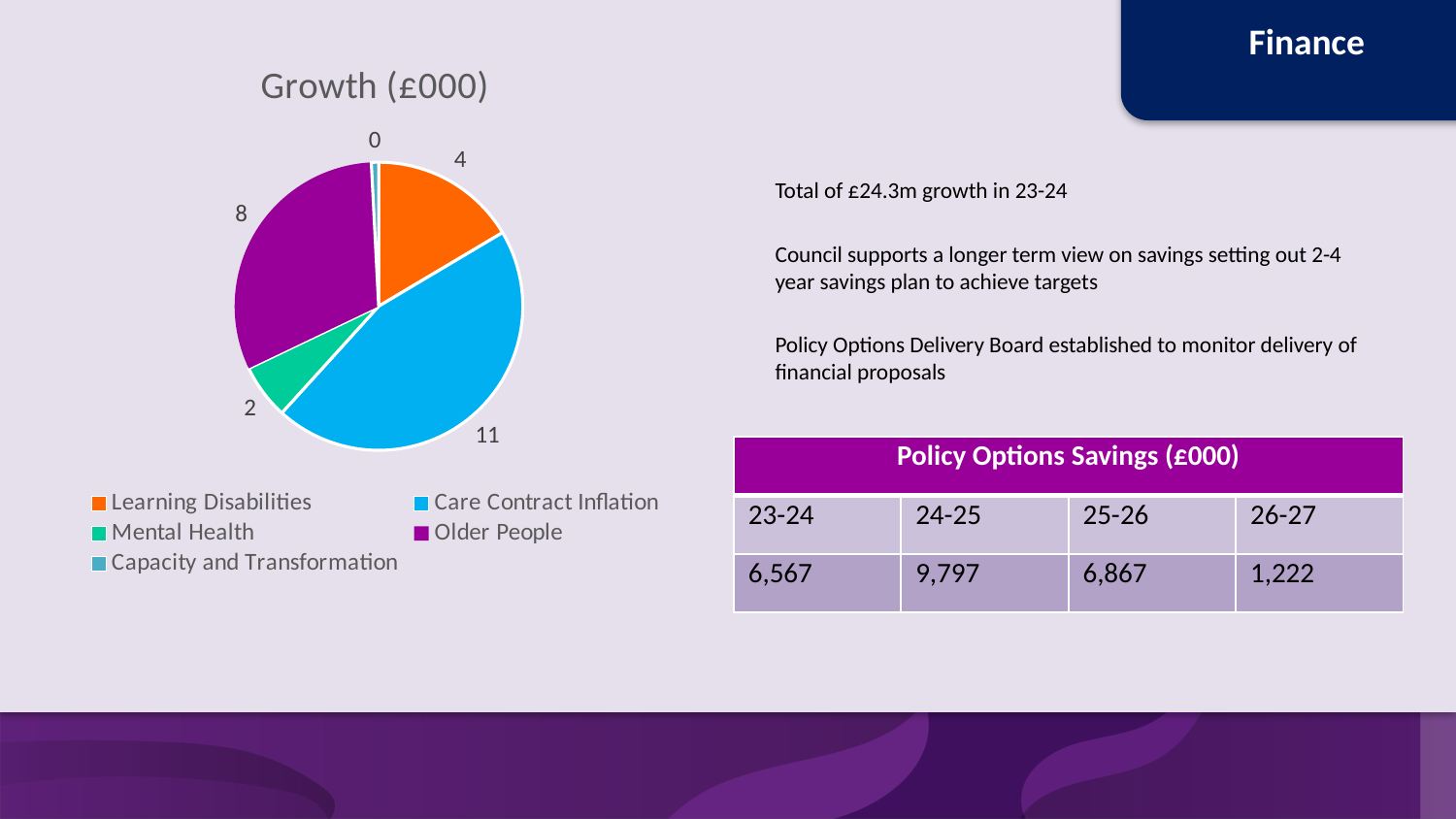
Which category has the largest slice of the pie? Care Contract Inflation What is the value for Care Contract Inflation? 11 What is the value for Capacity and Transformation? 0 What is the difference between the values for Care Contract Inflation and Older People? 3 What type of chart is shown on the slide? Pie chart Which category has the smallest slice of the pie? Capacity and Transformation What is the title of the chart? Growth (£000) What is the value for Mental Health? 2 What is the value for Learning Disabilities? 4 What is the value for Older People? 8 How many categories does the legend list? 5 Which is larger, the value for Learning Disabilities or the value for Mental Health? Learning Disabilities